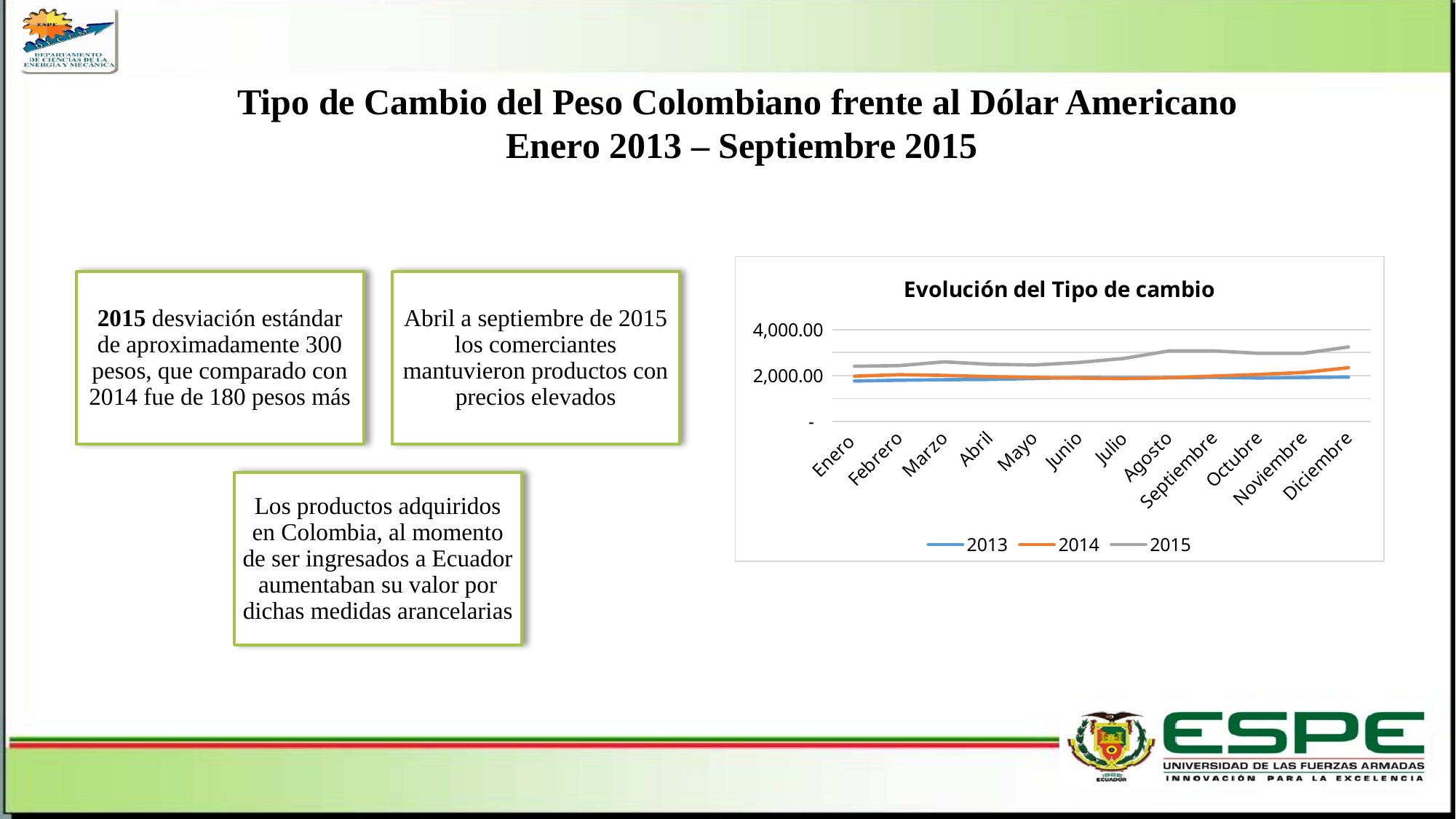
In the "Evolución del Tipo de cambio" chart, which is higher in Diciembre, the 2015 series or the 2013 series? 2015 How many months are shown on the x axis of the "Evolución del Tipo de cambio" chart? 12 In the "Evolución del Tipo de cambio" chart, is the value for 2015 in Diciembre greater or less than 4,000.00? less How many series does the legend of the "Evolución del Tipo de cambio" chart list? 3 Which series are listed in the legend of the "Evolución del Tipo de cambio" chart? 2013, 2014, 2015 In the "Evolución del Tipo de cambio" chart, is the value for 2013 in Enero greater or less than 2,000.00? less In the "Evolución del Tipo de cambio" chart, does the 2015 series rise or fall overall from Enero to Diciembre? rise What kind of chart is "Evolución del Tipo de cambio"? line chart In the "Evolución del Tipo de cambio" chart, is the value for 2014 in Diciembre greater or less than 2,000.00? greater What is the title of the chart on the slide? Evolución del Tipo de cambio In the "Evolución del Tipo de cambio" chart, which series has the highest value in Agosto? 2015